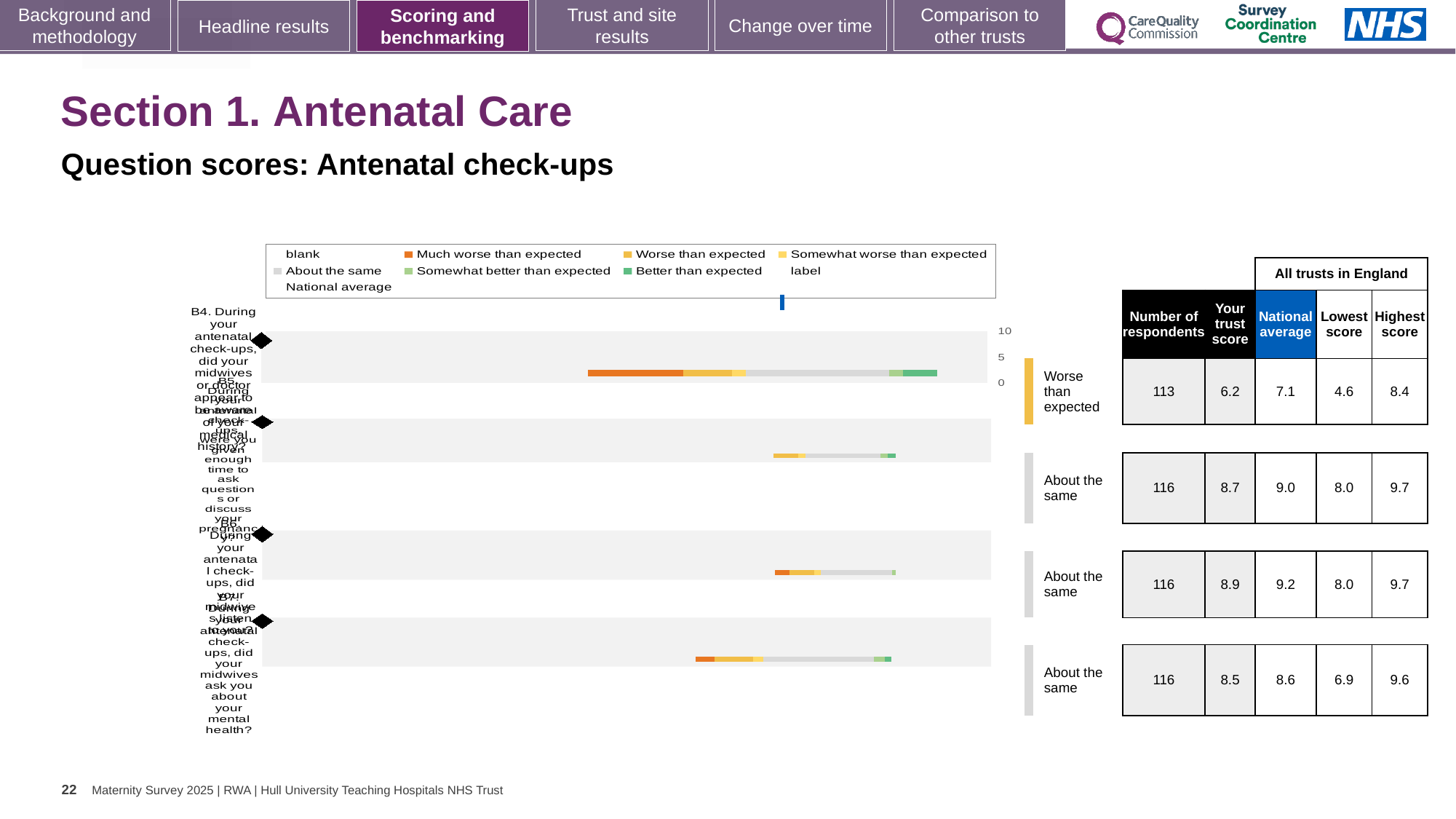
In the table beside the chart, which row has the lowest 'Your trust score'? the first row (B4), 6.2 In the chart legend, which colour represents 'Much worse than expected'? orange In the table beside the chart, what is the highest score for the last row (B7)? 9.6 In the table beside the chart, what is 'Your trust score' for the first row (B4)? 6.2 How many question rows (bars) does the chart show? 4 In the table beside the chart, which row has the highest 'Your trust score'? the third row (B6), 8.9 What kind of chart is shown on the slide? bar chart In the table beside the chart, what is the number of respondents for the first row (B4)? 113 In the table beside the chart, what is the national average for the first row (B4)? 7.1 In the chart legend, which colour represents 'Better than expected'? green In the table beside the chart, what is the difference between the national average and 'Your trust score' for the first row (B4)? 0.9 Which row of the chart is labelled 'Worse than expected'? the first row (B4)